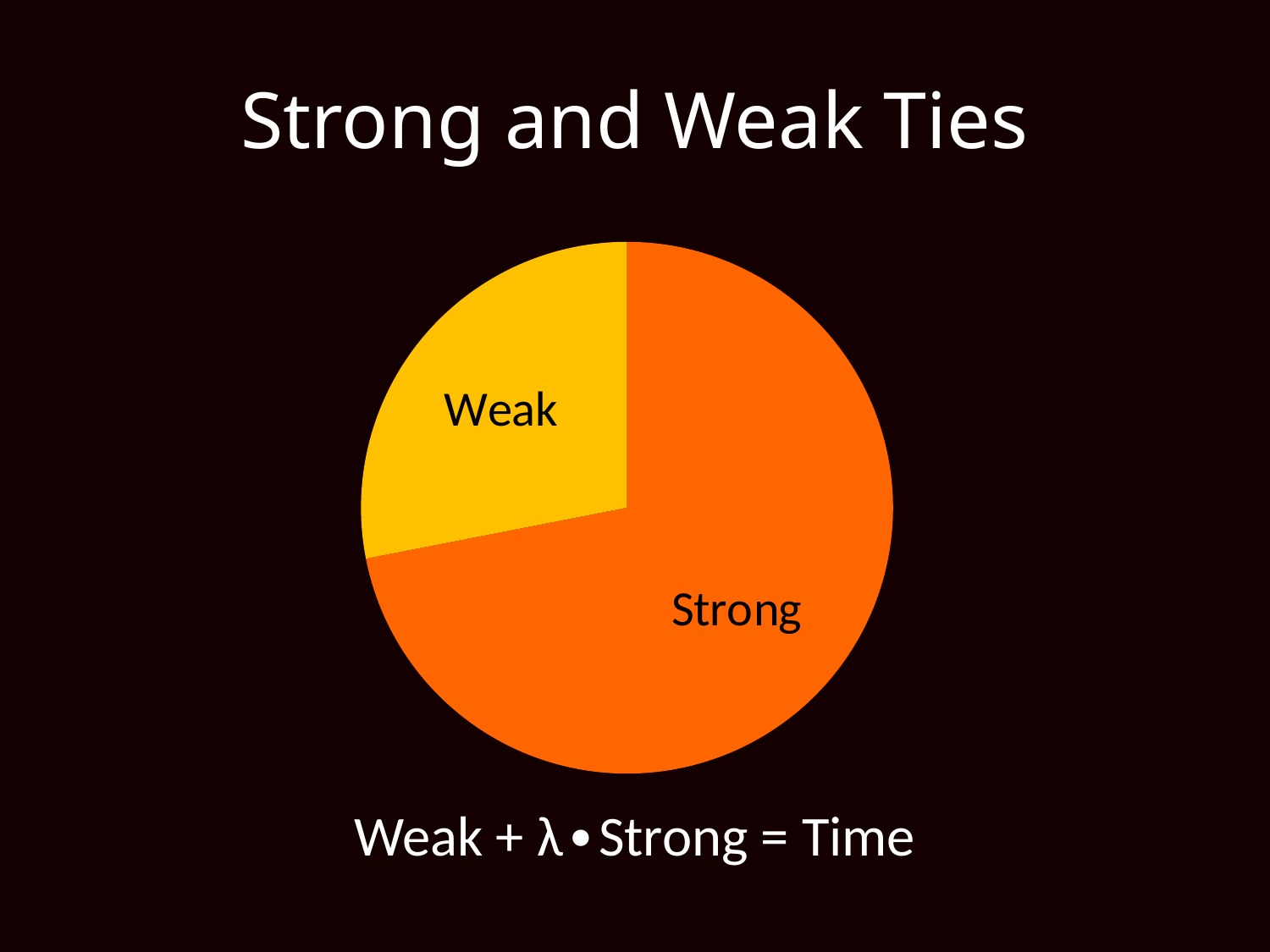
What is the title of the slide containing the pie chart? Strong and Weak Ties What kind of chart is shown on the slide? pie chart Which slice is larger, Weak or Strong? Strong How many slices does the pie chart have? 2 What colour is the Weak slice of the pie chart? yellow Which slice of the pie chart is the largest? Strong Which slice of the pie chart is the smallest? Weak Does the Strong slice take up more or less than half of the pie? more